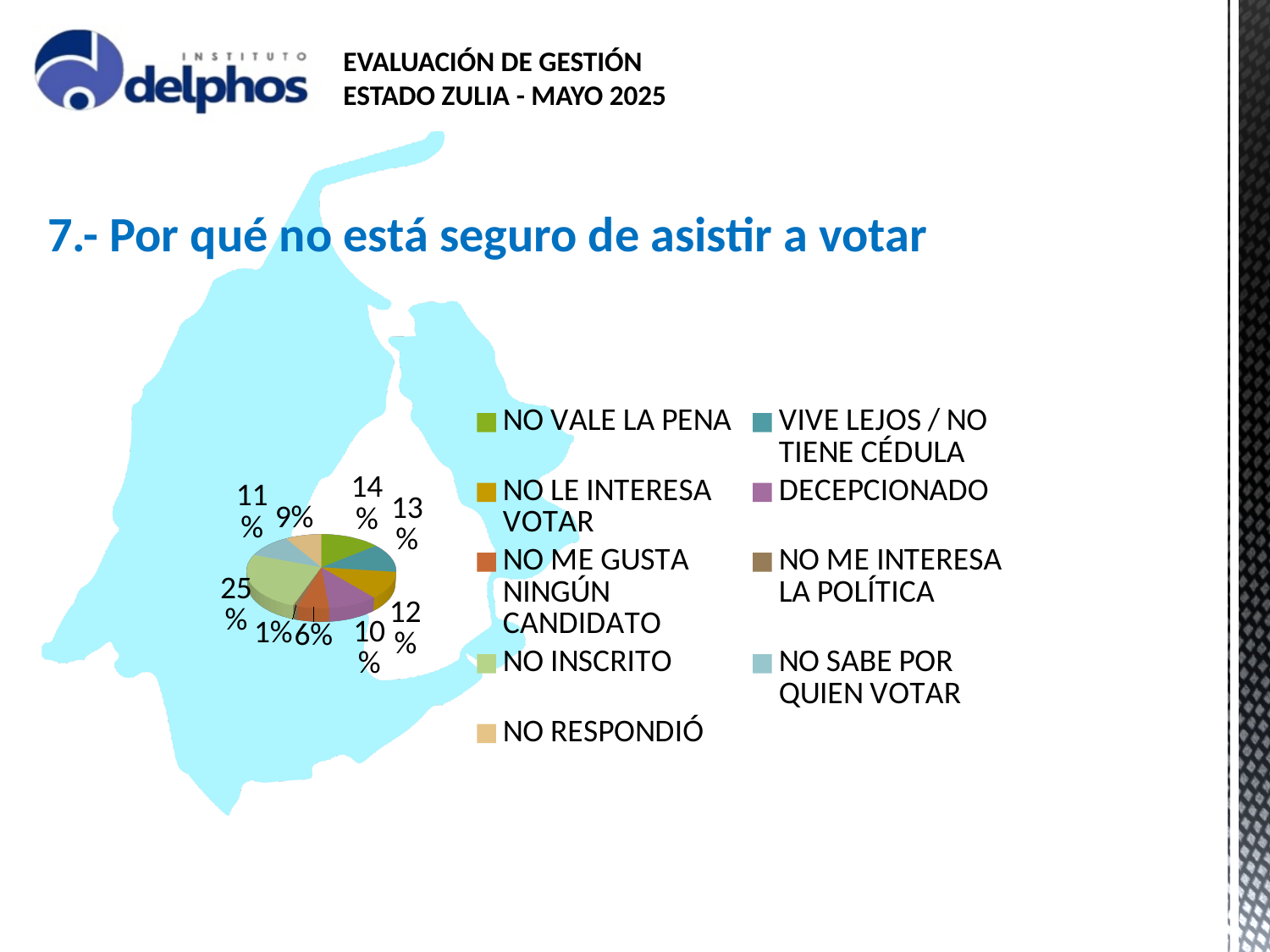
What is the largest percentage shown on the pie chart? 25% Which legend entry is shown in purple? DECEPCIONADO What is the smallest percentage shown on the pie chart? 1% What is the difference between the largest slice (25%) and the smallest slice (1%)? 24% What share of the pie does VIVE LEJOS / NO TIENE CÉDULA have? 13% Which category has the largest share of the pie chart? NO INSCRITO What share of the pie does NO INSCRITO have? 25% What share of the pie does NO VALE LA PENA have? 14% What is the title of the chart on the slide? 7.- Por qué no está seguro de asistir a votar What kind of chart is shown on the slide? pie chart Which is larger, the NO INSCRITO slice or the NO VALE LA PENA slice? NO INSCRITO How many categories does the legend of the pie chart list? 9